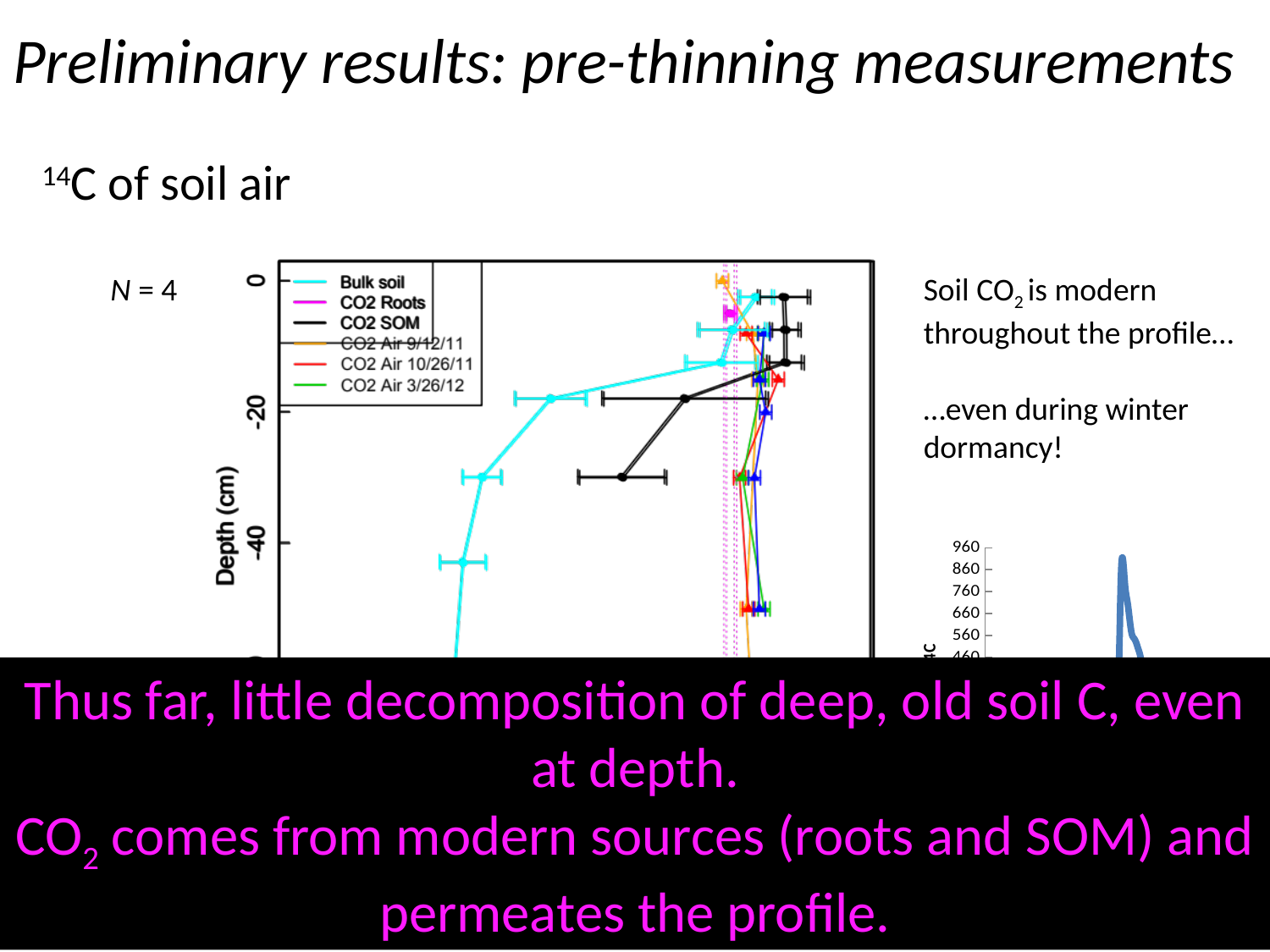
In the depth-profile chart, which series reaches the lowest 14C values at depth? Bulk soil In the depth-profile chart at about 30 cm depth, which has the lower 14C value, CO2 SOM or the CO2 Air series? CO2 SOM In the depth-profile chart at about 30 cm depth, which has the lower 14C value, Bulk soil or CO2 SOM? Bulk soil In the depth-profile chart, does the Bulk soil 14C value increase or decrease as depth increases? decrease Which colour is used for the Bulk soil series in the depth-profile chart? cyan What kind of chart is the depth-profile chart of 14C of soil air? line chart How many CO2 Air sampling dates are listed in the legend of the depth-profile chart? 3 What is the label of the vertical axis on the depth-profile chart? Depth (cm) How many series does the legend of the depth-profile chart list? 6